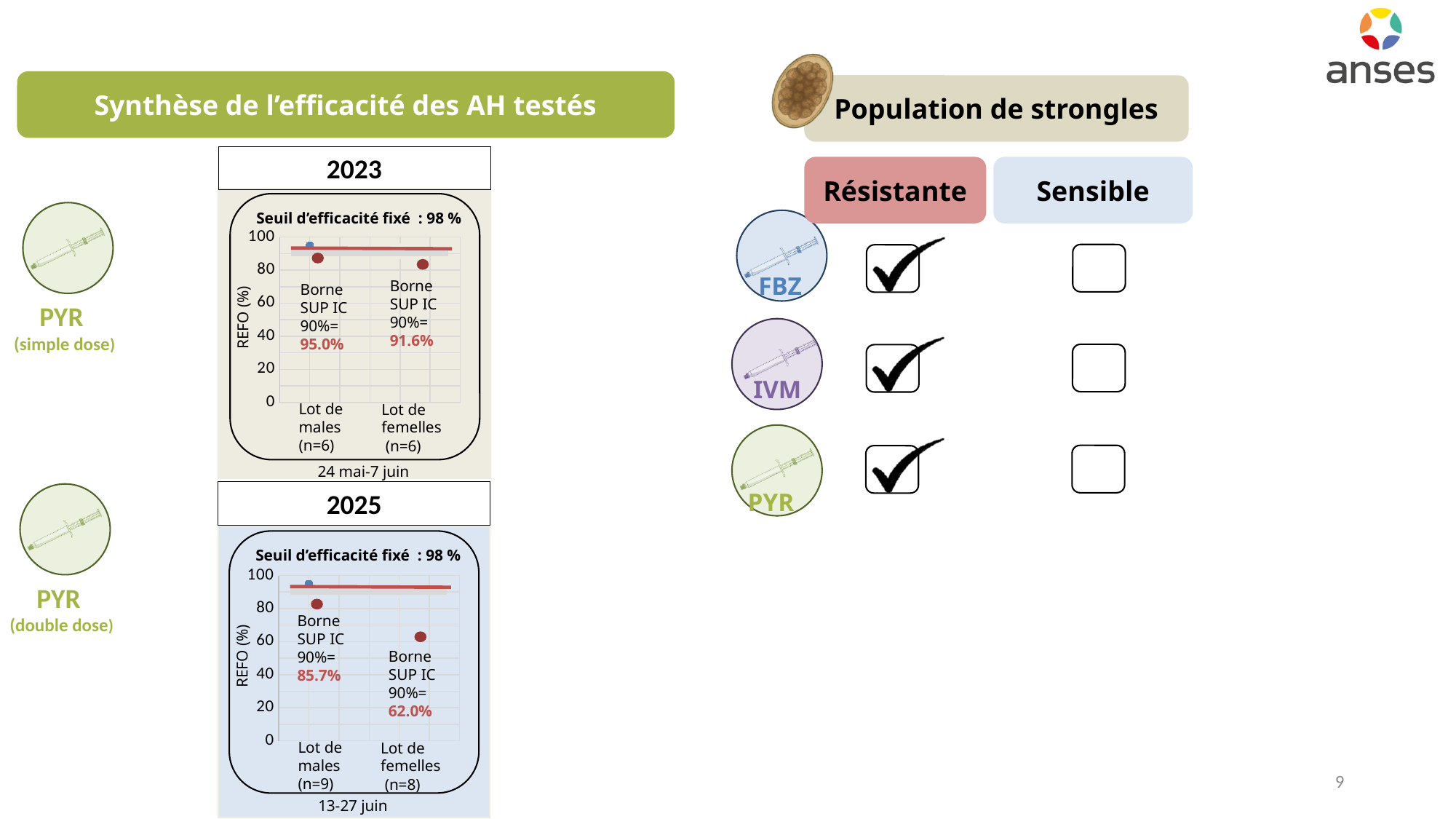
In the 2025 chart, which lot has the lower 'Borne SUP IC 90%' value? Lot de femelles In the 2023 chart, what is the 'Borne SUP IC 90%' value printed for the Lot de males? 95.0% What efficacy threshold ('Seuil d'efficacité fixé') is stated on the 2023 chart? 98 % In the 2025 chart, what is the 'Borne SUP IC 90%' value printed for the Lot de males? 85.7% In the 2025 chart, is the plotted REFO value for the Lot de femelles greater or less than 80? less In the 2025 chart, what is the 'Borne SUP IC 90%' value printed for the Lot de femelles? 62.0% How many lots (categories) are plotted on the x axis of the 2025 chart? 2 In the 2023 chart, what is the difference between the 'Borne SUP IC 90%' values of the Lot de males and the Lot de femelles? 3.4% In the 2023 chart, what is the 'Borne SUP IC 90%' value printed for the Lot de femelles? 91.6% In the 2025 chart, what is the difference between the 'Borne SUP IC 90%' values of the Lot de males and the Lot de femelles? 23.7% In the 2023 chart, is the plotted REFO value for the Lot de males greater or less than 80? greater What is the y-axis label of the 2025 chart? REFO (%)